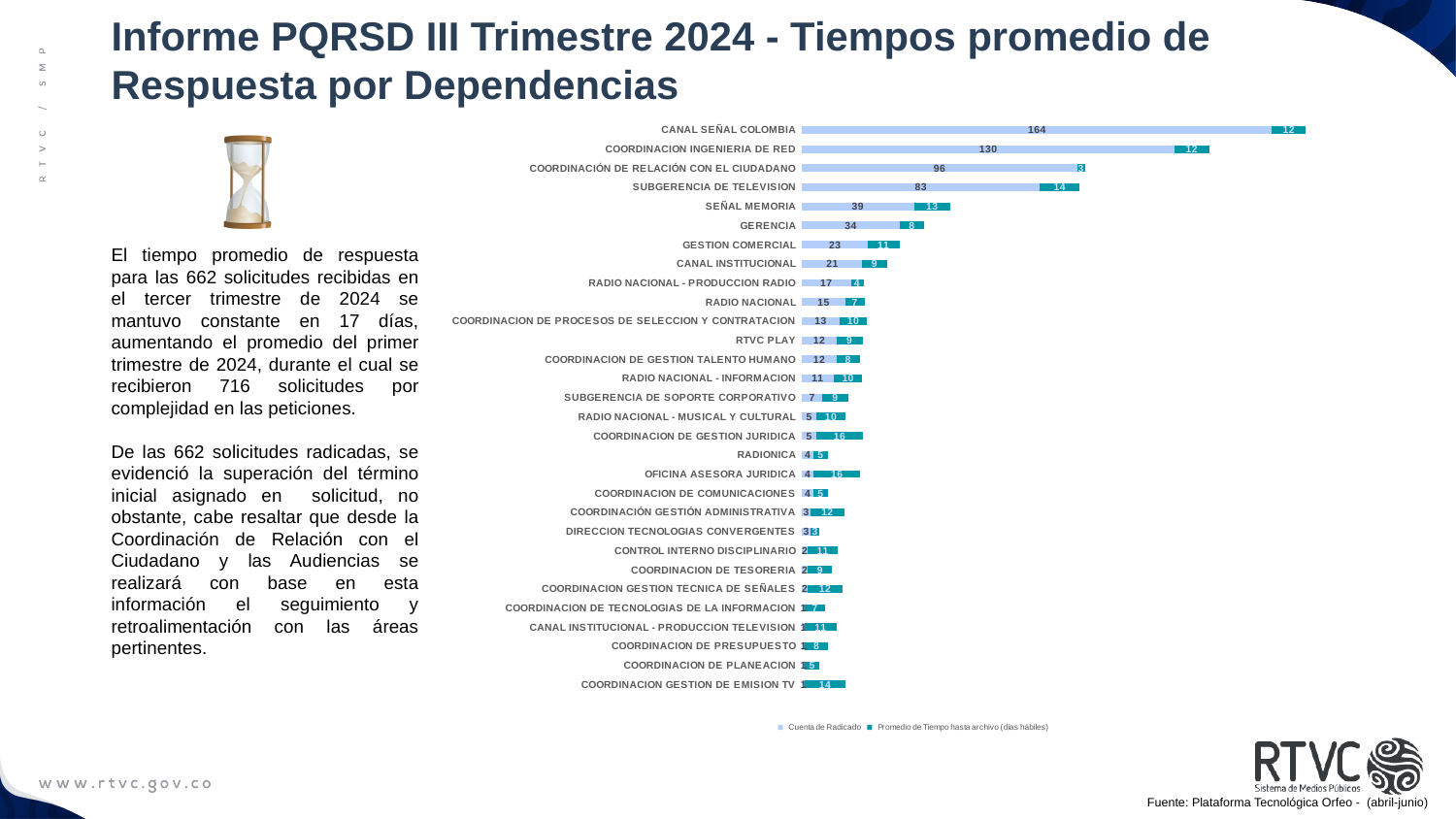
What is the 'Cuenta de Radicado' value for GESTION COMERCIAL? 23 Which has a larger 'Cuenta de Radicado' value, SEÑAL MEMORIA or GERENCIA? SEÑAL MEMORIA What is the 'Cuenta de Radicado' value for CANAL SEÑAL COLOMBIA? 164 What is the 'Promedio de Tiempo hasta archivo (días hábiles)' value for SUBGERENCIA DE TELEVISION? 14 What type of chart is shown on the slide? Bar chart What is the 'Promedio de Tiempo hasta archivo (días hábiles)' value for COORDINACIÓN DE RELACIÓN CON EL CIUDADANO? 3 What is the total of the stacked bar for SUBGERENCIA DE TELEVISION? 97 Which dependency has the highest 'Cuenta de Radicado' value? CANAL SEÑAL COLOMBIA How many series does the chart legend list? 2 What is the difference in 'Cuenta de Radicado' between CANAL SEÑAL COLOMBIA and COORDINACION INGENIERIA DE RED? 34 What is the 'Cuenta de Radicado' value for COORDINACION INGENIERIA DE RED? 130 How many dependencies (categories) are shown in the chart? 30